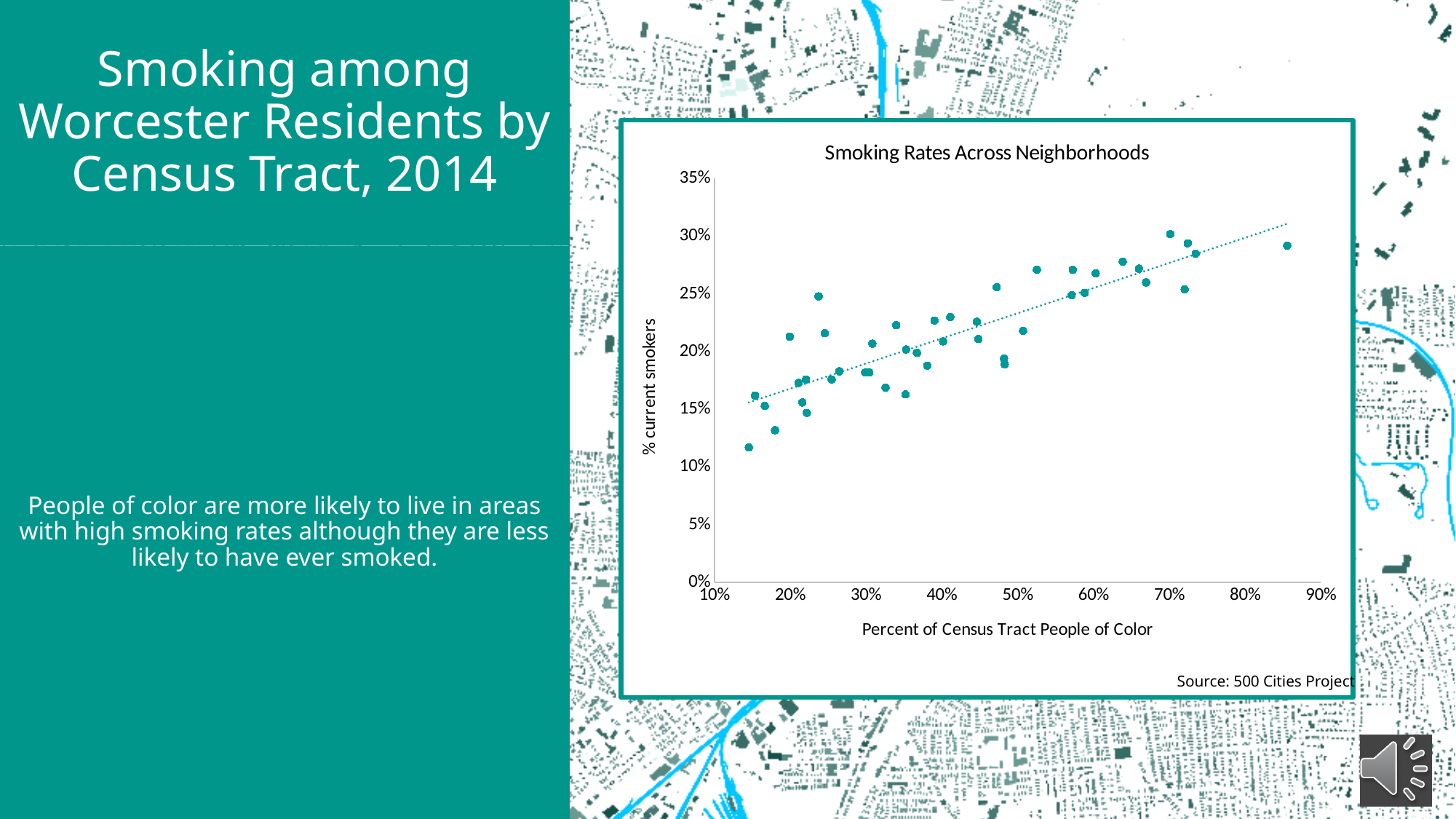
Does the dotted trend line slope upward or downward from left to right? upward What is the label of the x axis of the chart? Percent of Census Tract People of Color What is the highest value shown on the y axis of the chart? 35% What kind of chart is shown on the slide? scatter plot Is the smoking rate for the census tract with the highest percent of people of color (around 85%) greater or less than 25%? greater Do the smoking rates generally rise or fall as the percent of people of color in a census tract increases? rise Is the smoking rate for the census tract with the lowest percent of people of color (around 14%) greater or less than 15%? less Are any census tracts plotted with a smoking rate above 35%? No What is the title of the chart? Smoking Rates Across Neighborhoods